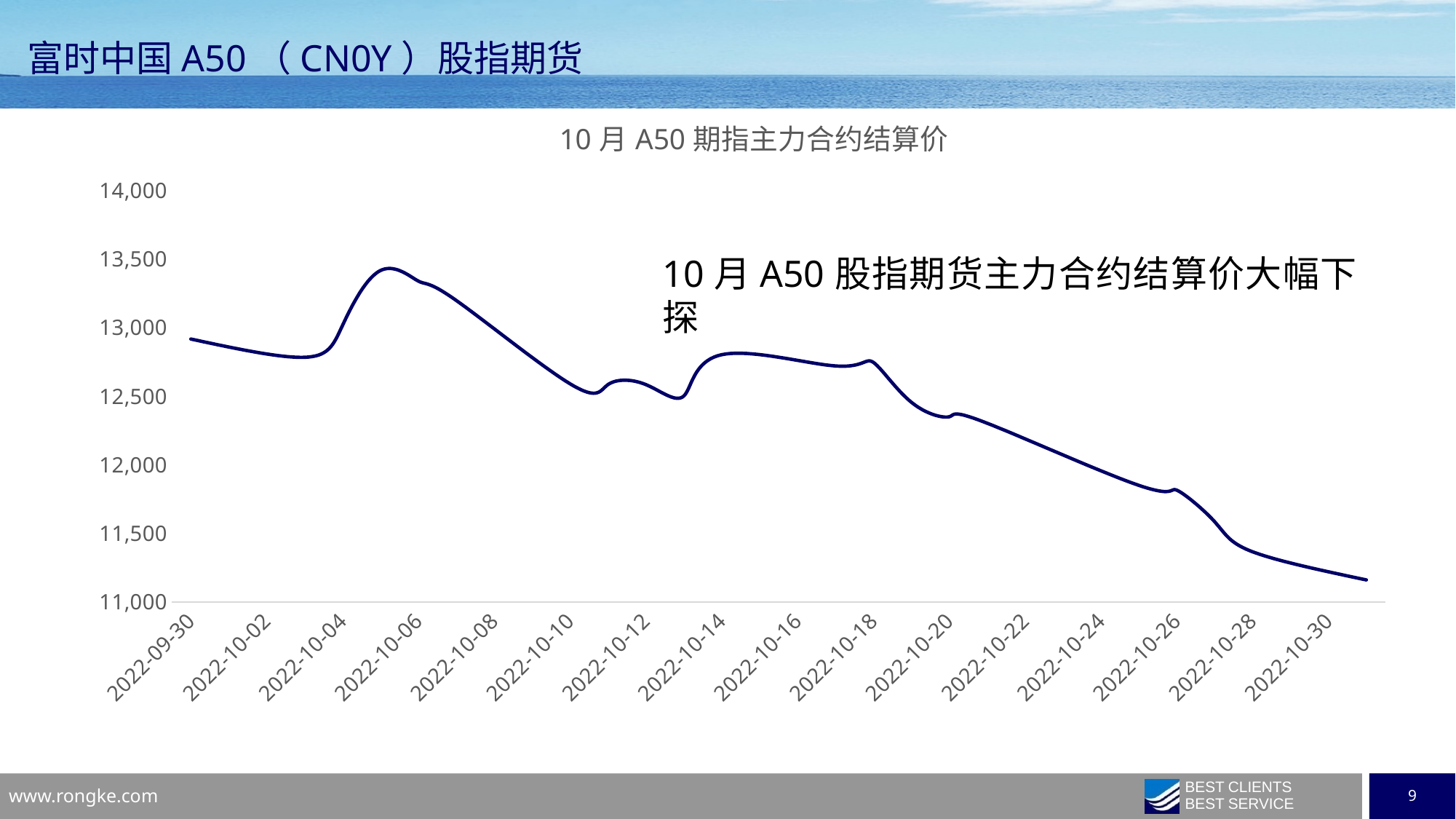
Is the value at 2022-10-20 greater or less than 12,500? less What is the title of the chart? 10月A50期指主力合约结算价 What kind of chart is shown on the slide? line chart Is the lowest value of the series at the start or at the end of the period? end Is the value at 2022-10-14 greater or less than 12,500? greater Is the value at 2022-10-26 greater or less than 12,000? less Which is larger, the value at 2022-10-06 or the value at 2022-10-30? 2022-10-06 How many date labels are shown on the x axis? 16 Which is larger, the value at 2022-09-30 or the value at 2022-10-20? 2022-09-30 Overall, do the values rise or fall from 2022-09-30 to the end of the period? fall